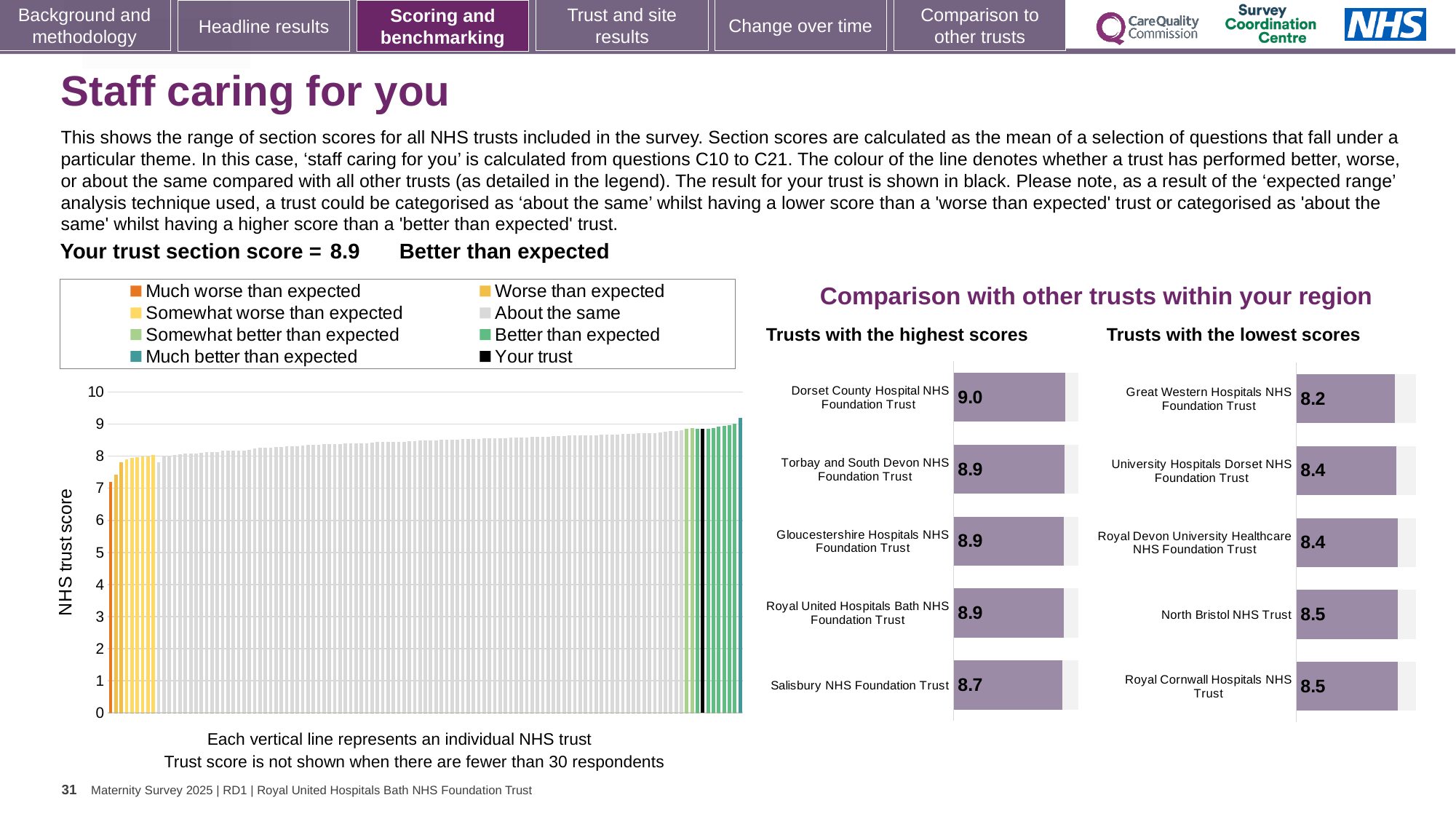
In the 'Trusts with the highest scores' chart, what is the difference between the scores of Dorset County Hospital NHS Foundation Trust and Salisbury NHS Foundation Trust? 0.3 In the 'Trusts with the lowest scores' chart, how many trusts are listed? 5 What kind of chart is the main 'NHS trust score' chart on the left? Bar chart In the 'Trusts with the lowest scores' chart, which trust has the lowest score? Great Western Hospitals NHS Foundation Trust In the main 'NHS trust score' chart on the left, what colour does the legend use for 'Your trust'? Black In the 'Trusts with the lowest scores' chart, what is the score for Great Western Hospitals NHS Foundation Trust? 8.2 In the main 'NHS trust score' chart on the left, is the value of the leftmost (orange) bar greater or less than 8? less In the 'Trusts with the lowest scores' chart, which has the larger score: Great Western Hospitals NHS Foundation Trust or North Bristol NHS Trust? North Bristol NHS Trust In the 'Trusts with the highest scores' chart, which trust has the highest score? Dorset County Hospital NHS Foundation Trust In the main 'NHS trust score' chart on the left, do the bar values rise or fall from left to right? Rise In the main 'NHS trust score' chart on the left, how many entries does the legend list? 8 In the 'Trusts with the highest scores' chart, what is the score for Dorset County Hospital NHS Foundation Trust? 9.0